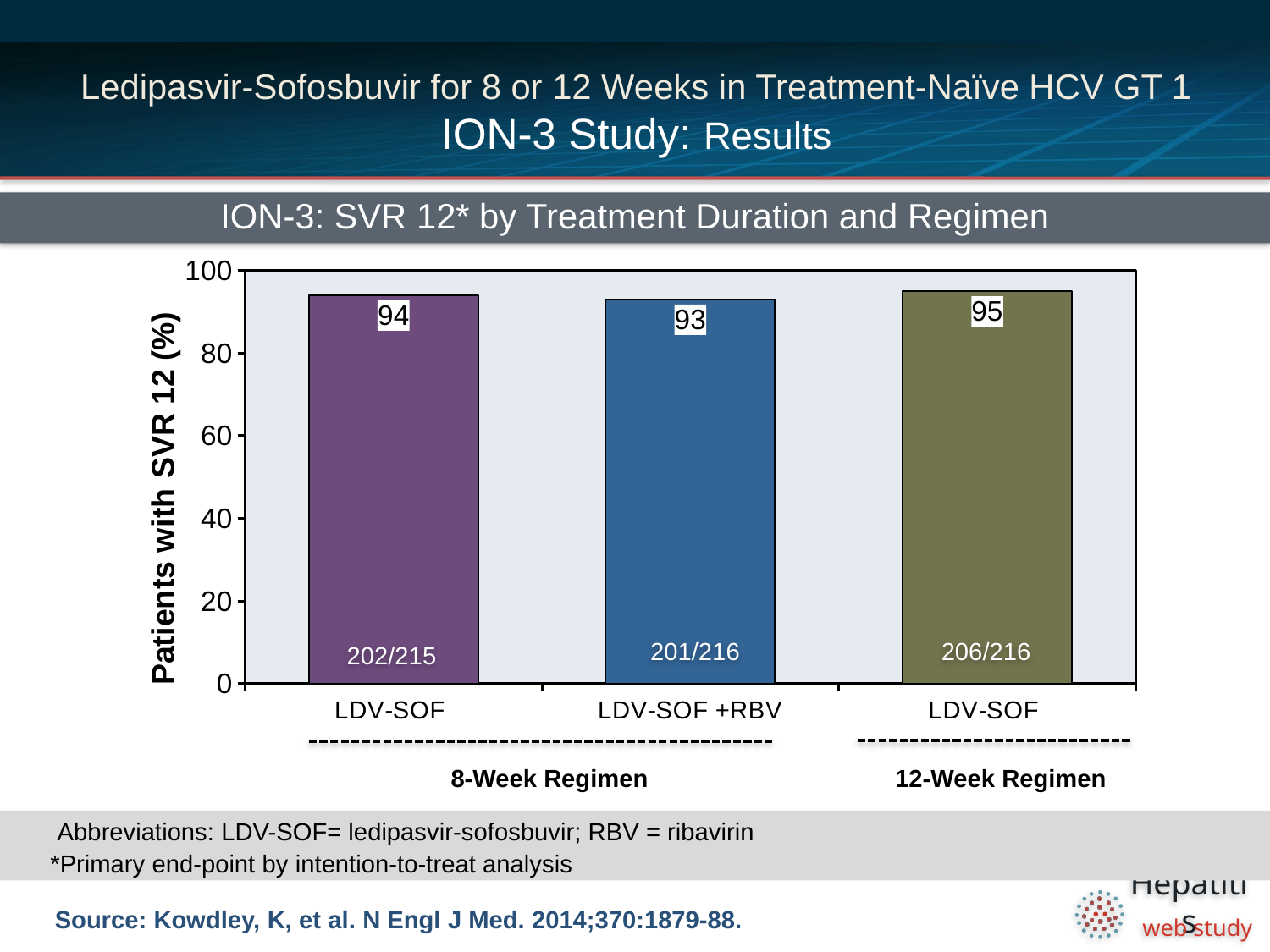
How many bars are plotted in the chart? 3 What is the label of the y-axis? Patients with SVR 12 (%) What is the SVR 12 rate for LDV-SOF in the 8-week regimen? 94 Which bar has the highest SVR 12 rate? LDV-SOF, 12-Week Regimen Which has a higher SVR 12 rate: 8-week LDV-SOF or 8-week LDV-SOF +RBV? 8-week LDV-SOF What is the SVR 12 rate for LDV-SOF +RBV in the 8-week regimen? 93 Which bar has the lowest SVR 12 rate? LDV-SOF +RBV, 8-Week Regimen What is the SVR 12 rate for LDV-SOF in the 12-week regimen? 95 What fraction of patients is shown inside the LDV-SOF +RBV bar? 201/216 What is the difference in SVR 12 rate between the 12-week LDV-SOF bar and the 8-week LDV-SOF +RBV bar? 2 What fraction of patients is shown inside the 12-week LDV-SOF bar? 206/216 What type of chart is shown on the slide? Bar chart